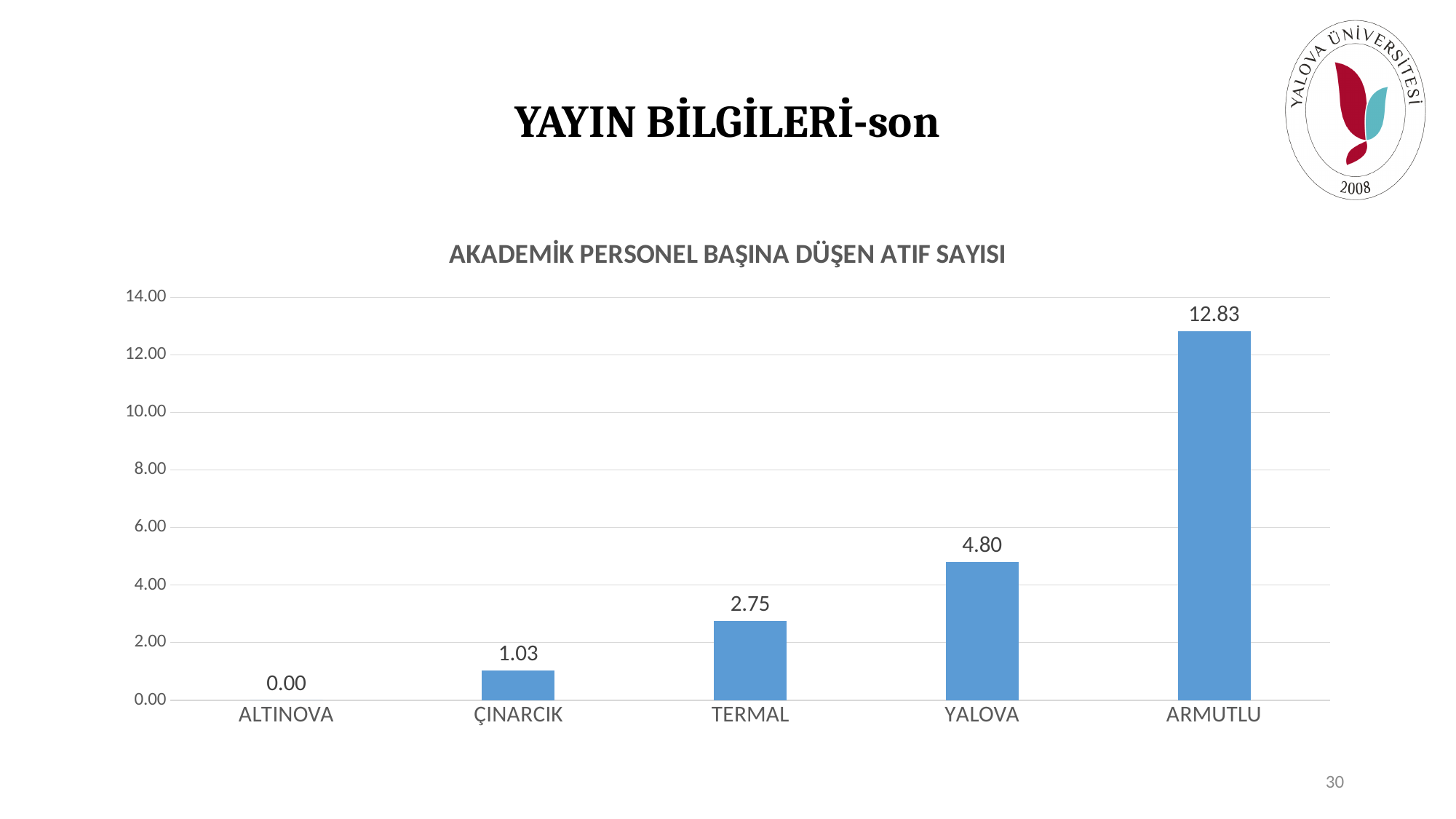
What is the value for ARMUTLU? 12.83 What is the value for TERMAL? 2.75 What is the value for ÇINARCIK? 1.03 Is the value for ARMUTLU greater or less than 12.00? greater What kind of chart is shown on the slide? bar chart What is the title of the chart? AKADEMİK PERSONEL BAŞINA DÜŞEN ATIF SAYISI What is the difference between the values for TERMAL and ÇINARCIK? 1.72 Which category has the highest value? ARMUTLU How many categories are shown on the x axis? 5 What is the difference between the values for ARMUTLU and YALOVA? 8.03 Which is larger, the value for YALOVA or the value for TERMAL? YALOVA Which category has the lowest value? ALTINOVA